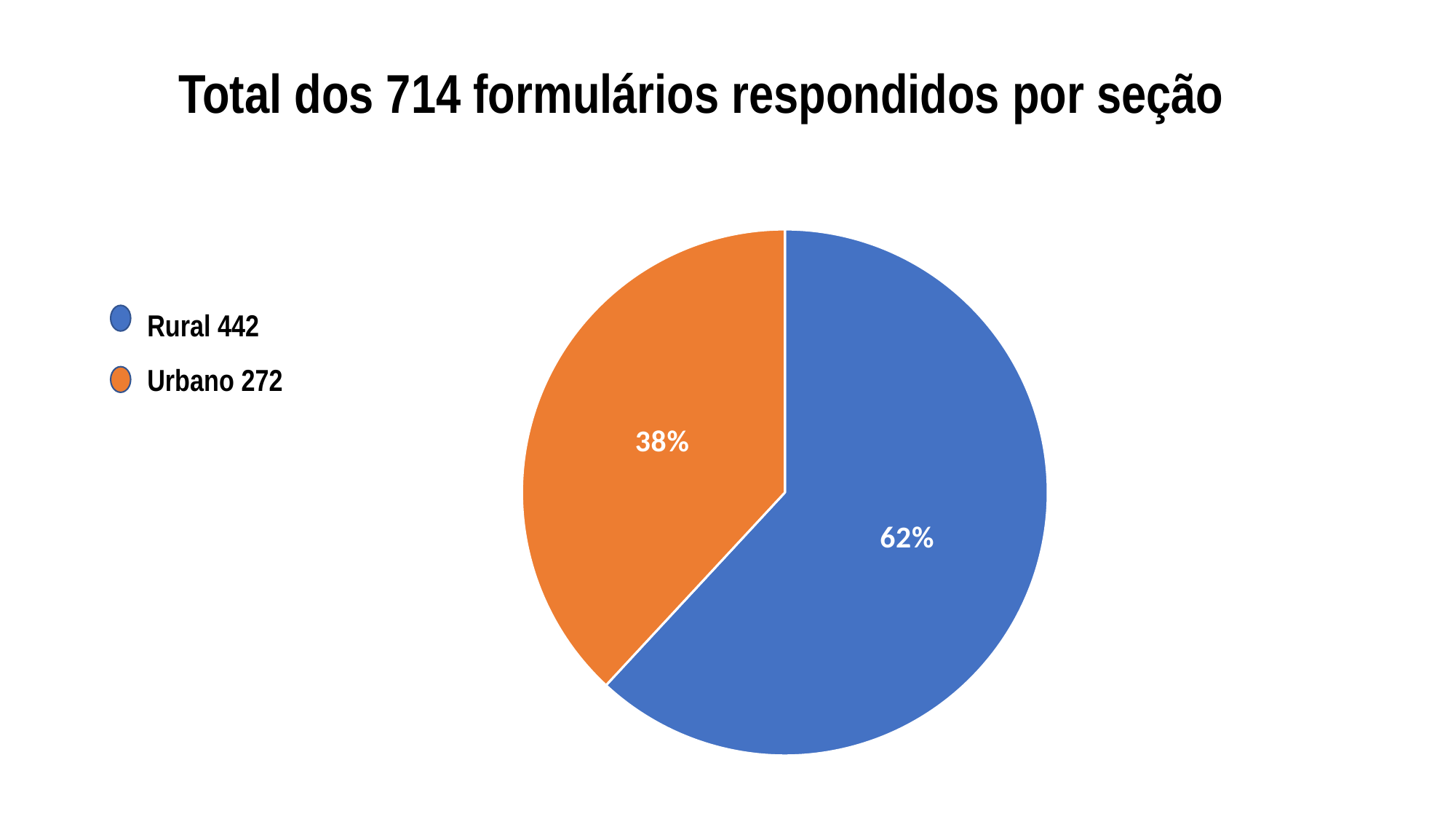
What percentage share of the pie does the Urbano slice represent? 38% What is the number of forms shown in the legend for Urbano? 272 What is the difference between the Rural and Urbano counts shown in the legend? 170 What is the title of the chart? Total dos 714 formulários respondidos por seção What is the number of forms shown in the legend for Rural? 442 Which section has the smallest slice of the pie? Urbano What kind of chart is shown on the slide? pie chart Which colour represents Urbano in the pie chart? orange How many entries does the legend list? 2 Which section has the largest slice of the pie? Rural How many slices does the pie chart have? 2 What percentage share of the pie does the Rural slice represent? 62%